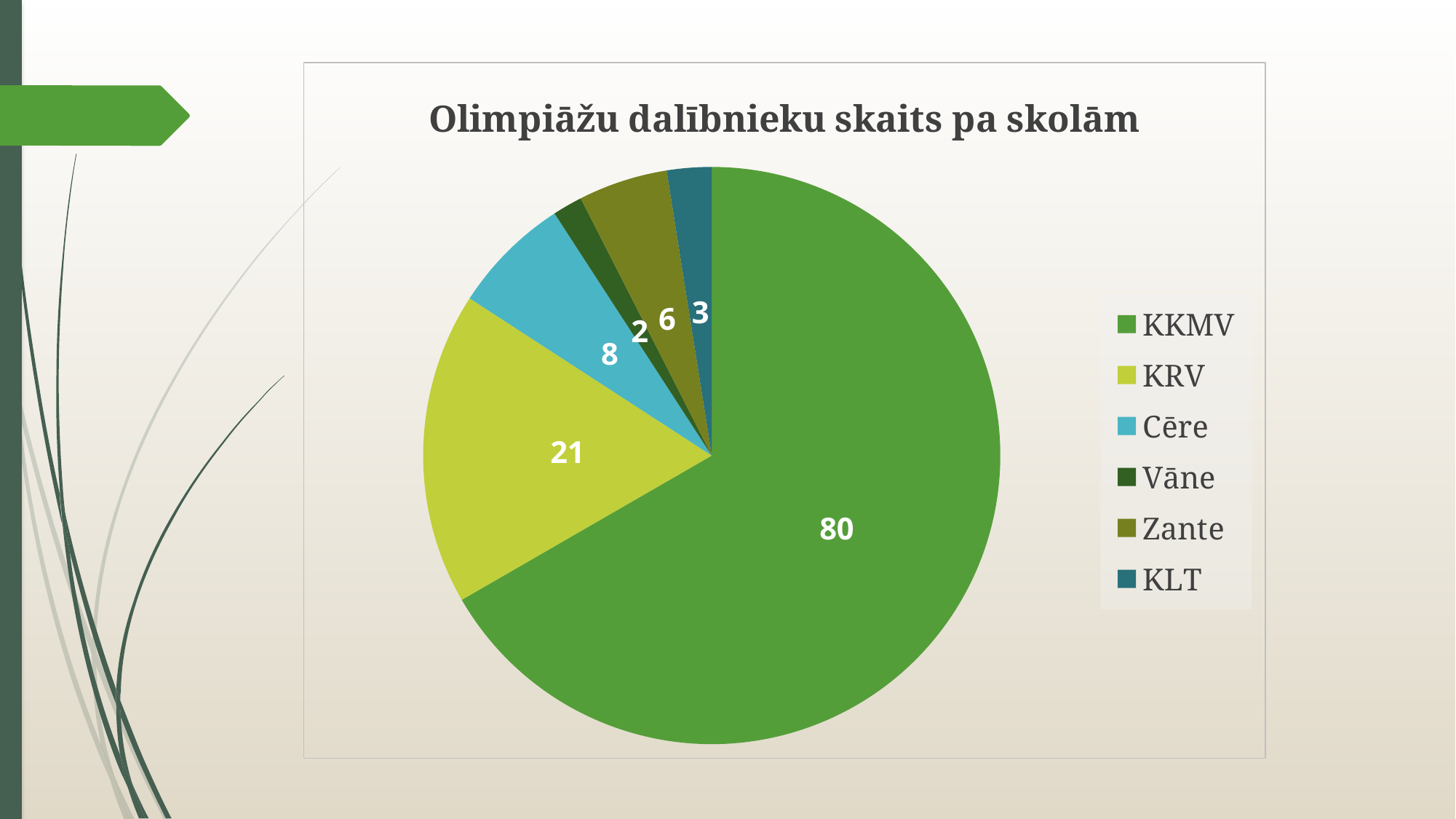
What share of the total does the Zante slice represent? 5% Which school has the largest slice of the pie? KKMV What is the value for KKMV? 80 What type of chart is shown on the slide? pie chart What is the difference between the values for KKMV and KRV? 59 Which school has the smallest slice of the pie? Vāne What is the value for Zante? 6 Which is larger, the value for Zante or the value for KLT? Zante What is the title of the chart? Olimpiāžu dalībnieku skaits pa skolām How many schools (slices) does the pie chart show? 6 What is the value for KRV? 21 What is the value for Cēre? 8